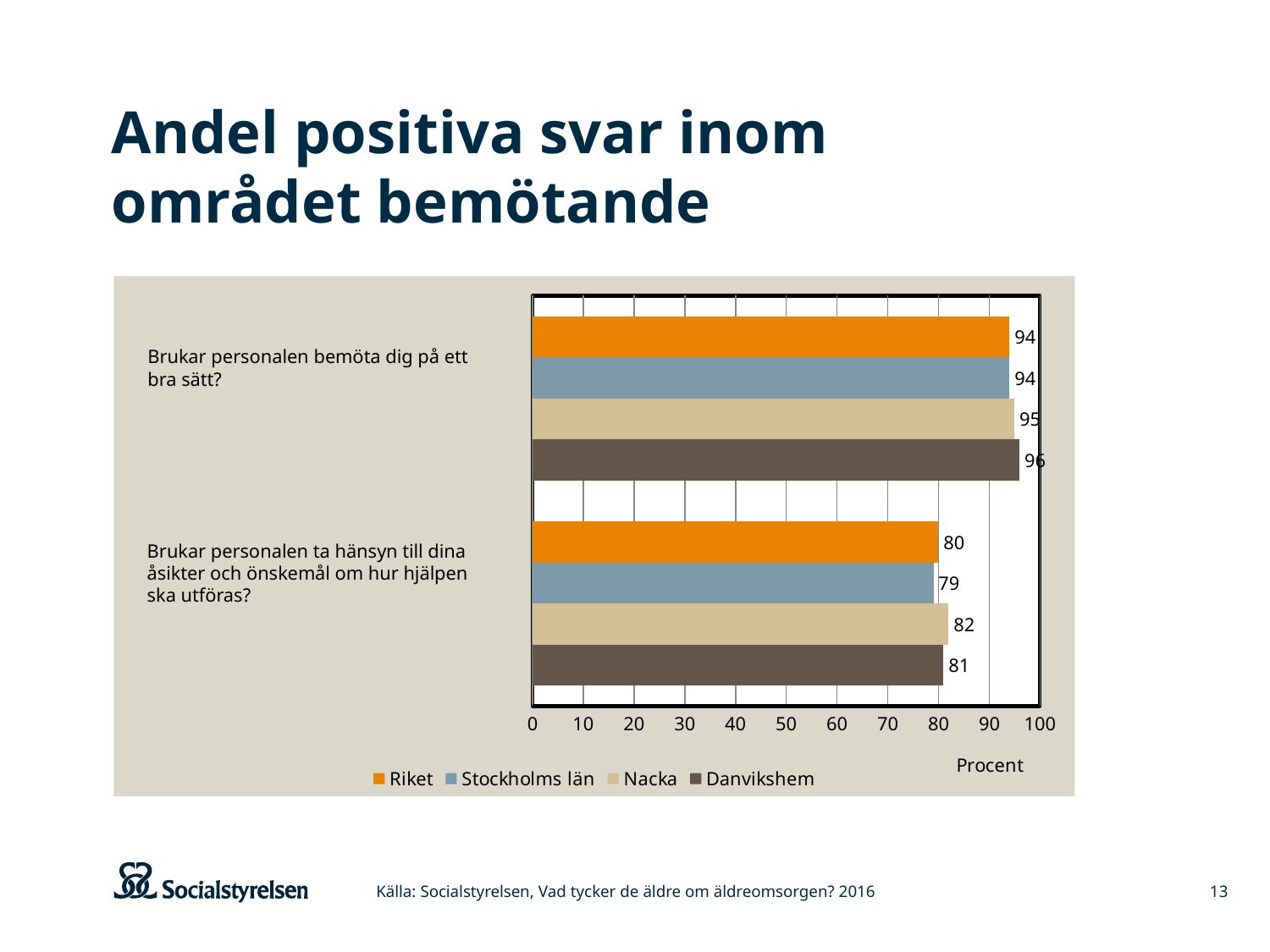
Which series has the lowest value for the question "Brukar personalen ta hänsyn till dina åsikter och önskemål om hur hjälpen ska utföras?"? Stockholms län What is the difference between Nacka and Stockholms län for the question "Brukar personalen ta hänsyn till dina åsikter och önskemål om hur hjälpen ska utföras?"? 3 How many series does the legend list? 4 Which series has the highest value for the question "Brukar personalen ta hänsyn till dina åsikter och önskemål om hur hjälpen ska utföras?"? Nacka What is the value for Stockholms län for the question "Brukar personalen ta hänsyn till dina åsikter och önskemål om hur hjälpen ska utföras?"? 79 What kind of chart is shown on the slide? bar chart What is the value for Nacka for the question "Brukar personalen bemöta dig på ett bra sätt?"? 95 How many questions (categories) are shown on the chart? 2 What is the label on the horizontal axis of the chart? Procent What is the value for Riket for the question "Brukar personalen ta hänsyn till dina åsikter och önskemål om hur hjälpen ska utföras?"? 80 What is the difference between the Danvikshem values for the two questions? 15 What is the value for Danvikshem for the question "Brukar personalen bemöta dig på ett bra sätt?"? 96